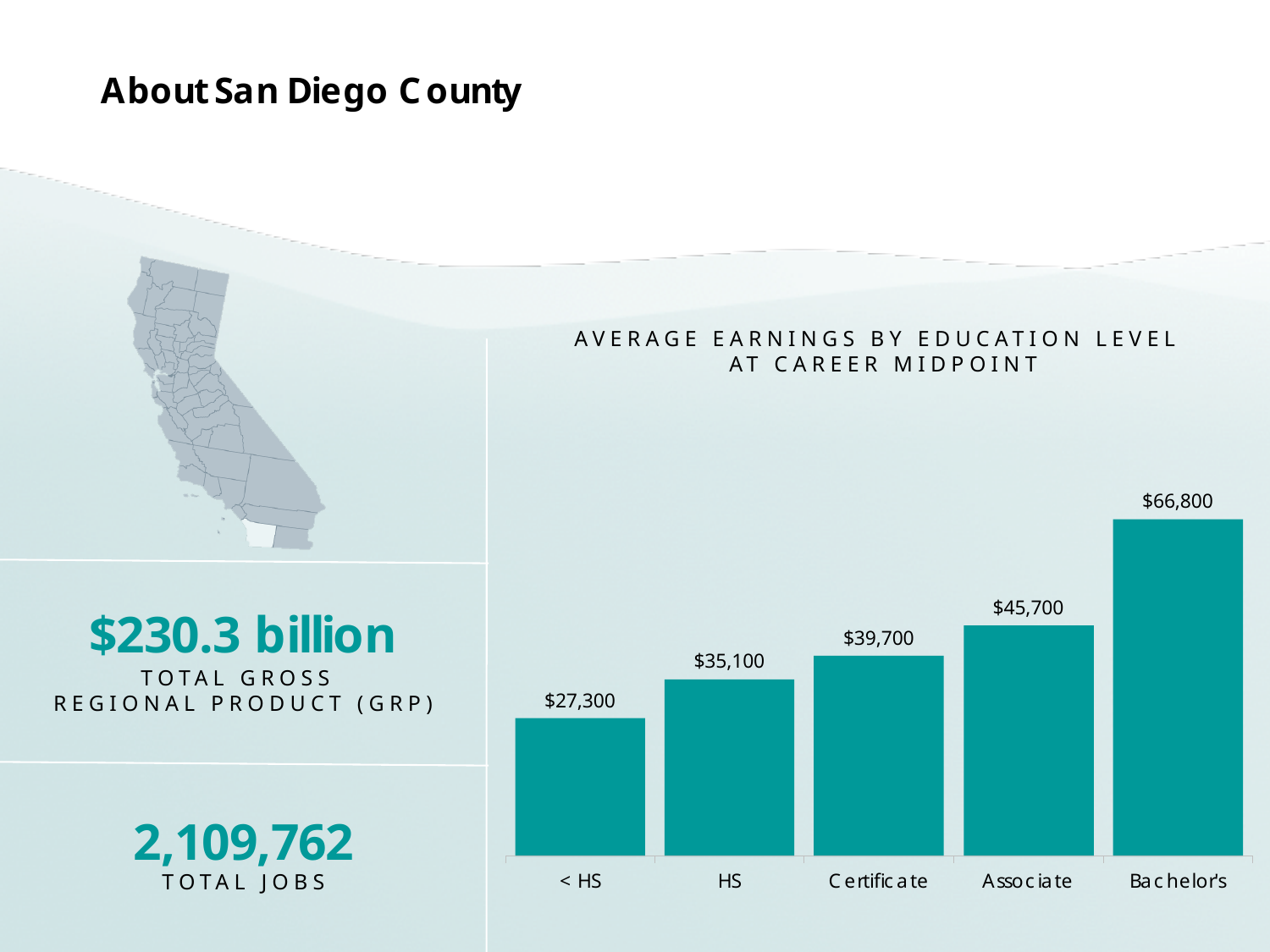
What is the average earnings at career midpoint for the < HS education level? $27,300 Which education level has the lowest average earnings at career midpoint? < HS How many education levels are shown in the chart? 5 Do average earnings rise or fall as education level increases from < HS to Bachelor's? Rise What kind of chart is used to show average earnings by education level? Bar chart What is the difference in average earnings between the Bachelor's and Associate education levels? $21,100 What is the difference in average earnings between the HS and < HS education levels? $7,800 Which has higher average earnings at career midpoint, Certificate or Associate? Associate What is the average earnings at career midpoint for the Certificate education level? $39,700 What is the average earnings at career midpoint for the Bachelor's education level? $66,800 What is the title of the chart on the slide? Average Earnings by Education Level at Career Midpoint Which education level has the highest average earnings at career midpoint? Bachelor's